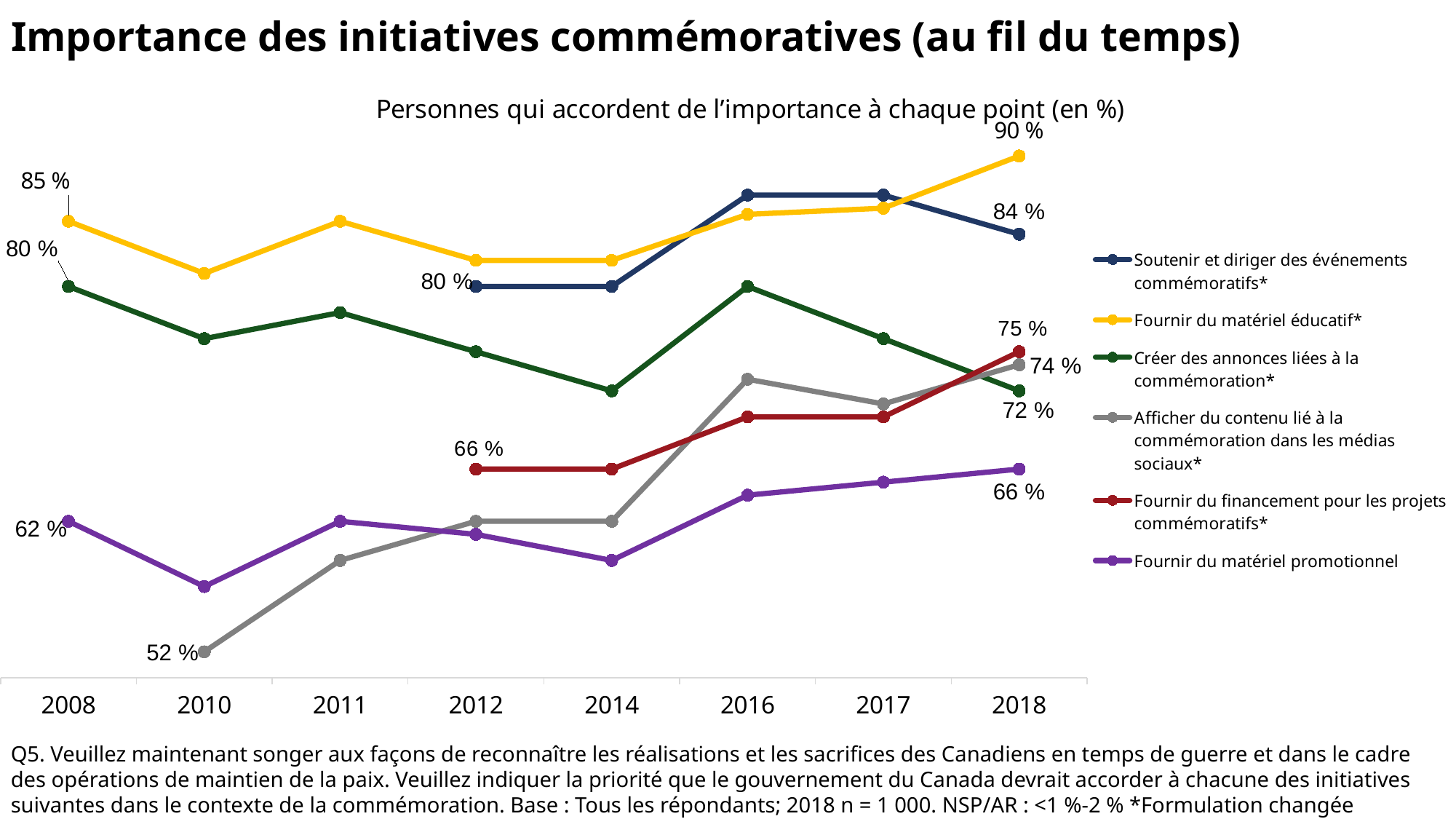
What is the value for "Soutenir et diriger des événements commémoratifs*" in 2018? 84 % What is the value for "Afficher du contenu lié à la commémoration dans les médias sociaux*" in 2010? 52 % What is the difference between the 2018 values for "Fournir du matériel éducatif*" and "Soutenir et diriger des événements commémoratifs*"? 6 percentage points Which series has the lowest value in 2018? Fournir du matériel promotionnel What type of chart is shown on the slide? Line chart What is the value for "Fournir du matériel éducatif*" in 2018? 90 % How many series does the legend list? 6 What is the value for "Fournir du financement pour les projets commémoratifs*" in 2012? 66 % Which is larger in 2018: "Créer des annonces liées à la commémoration*" or "Fournir du financement pour les projets commémoratifs*"? Fournir du financement pour les projets commémoratifs* How many years are shown on the x axis? 8 Does the value for "Afficher du contenu lié à la commémoration dans les médias sociaux*" rise or fall from 2010 to 2018? Rise Which series has the highest value in 2018? Fournir du matériel éducatif*